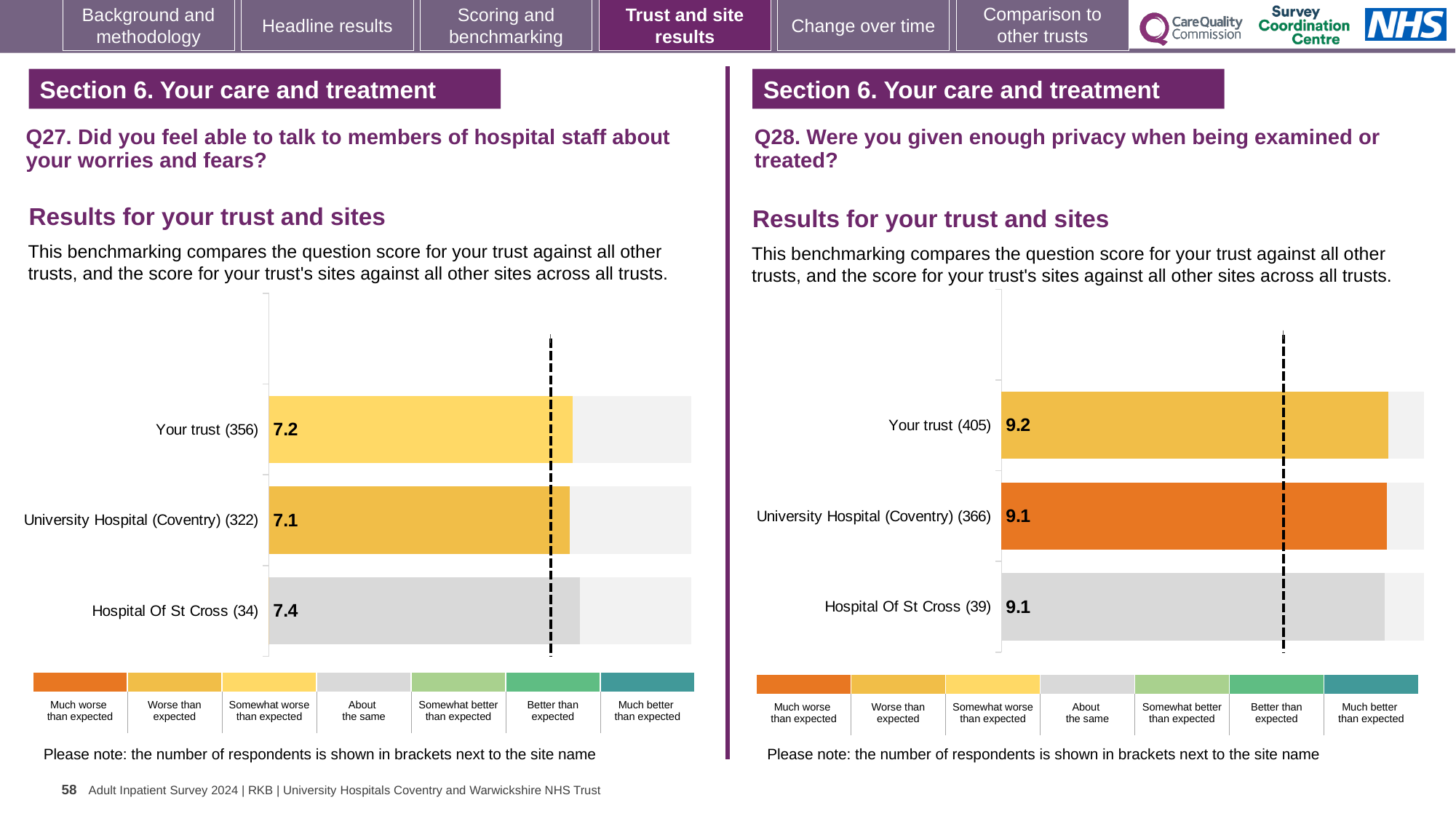
In the Q27 chart on the left, which site or trust has the highest score? Hospital Of St Cross In the Q27 chart on the left, what is the score for Hospital Of St Cross? 7.4 In the Q28 chart on the right, which site or trust has the highest score? Your trust In the Q27 chart on the left, how many respondents are shown for University Hospital (Coventry)? 322 How many bars are plotted in the Q28 chart on the right? 3 In the Q27 chart on the left, what is the difference between the scores for Hospital Of St Cross and University Hospital (Coventry)? 0.3 In the Q27 chart on the left, which site or trust has the lowest score? University Hospital (Coventry) In the Q28 chart on the right, what is the score for Your trust? 9.2 In the Q28 chart on the right, how many respondents are shown for Hospital Of St Cross? 39 In the Q27 chart on the left, what is the score for Your trust? 7.2 In the Q28 chart on the right, what is the score for University Hospital (Coventry)? 9.1 What type of chart is used for the Q27 results on the left? Bar chart